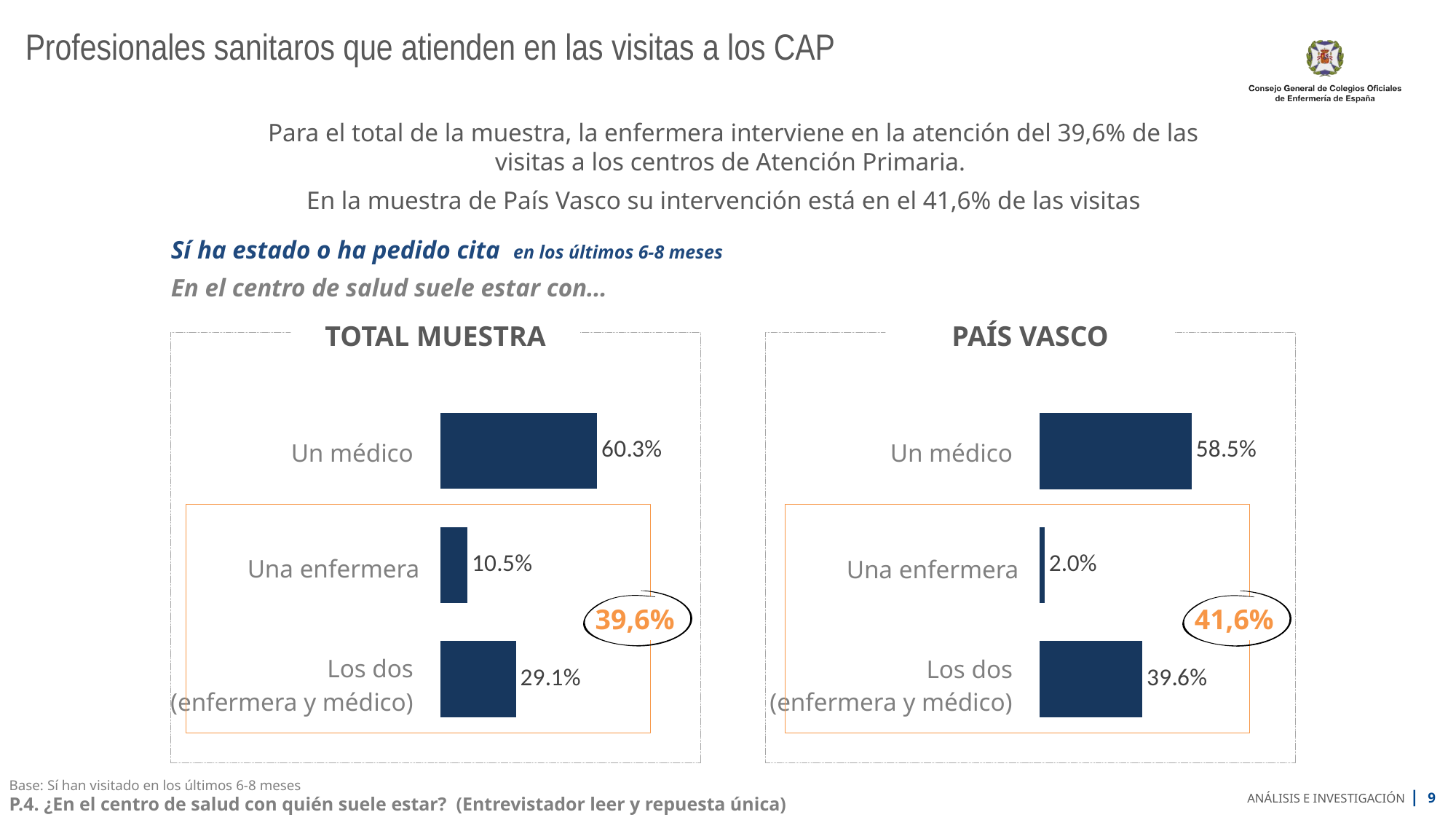
In the PAÍS VASCO chart, what is the value for Una enfermera? 2.0% In the PAÍS VASCO chart, what is the difference between Un médico and Una enfermera? 56.5% In the PAÍS VASCO chart, which category has the lowest value? Una enfermera What kind of chart is the TOTAL MUESTRA chart? Bar chart What value is circled in orange next to the PAÍS VASCO chart? 41,6% In the TOTAL MUESTRA chart, what is the value for Un médico? 60.3% In the TOTAL MUESTRA chart, which category has the highest value? Un médico In the TOTAL MUESTRA chart, what is the difference between Un médico and Los dos (enfermera y médico)? 31.2% How many categories does the PAÍS VASCO chart show? 3 In the PAÍS VASCO chart, what is the value for Los dos (enfermera y médico)? 39.6% In the TOTAL MUESTRA chart, what is the value for Una enfermera? 10.5% Which is larger: Una enfermera in the TOTAL MUESTRA chart or Una enfermera in the PAÍS VASCO chart? TOTAL MUESTRA